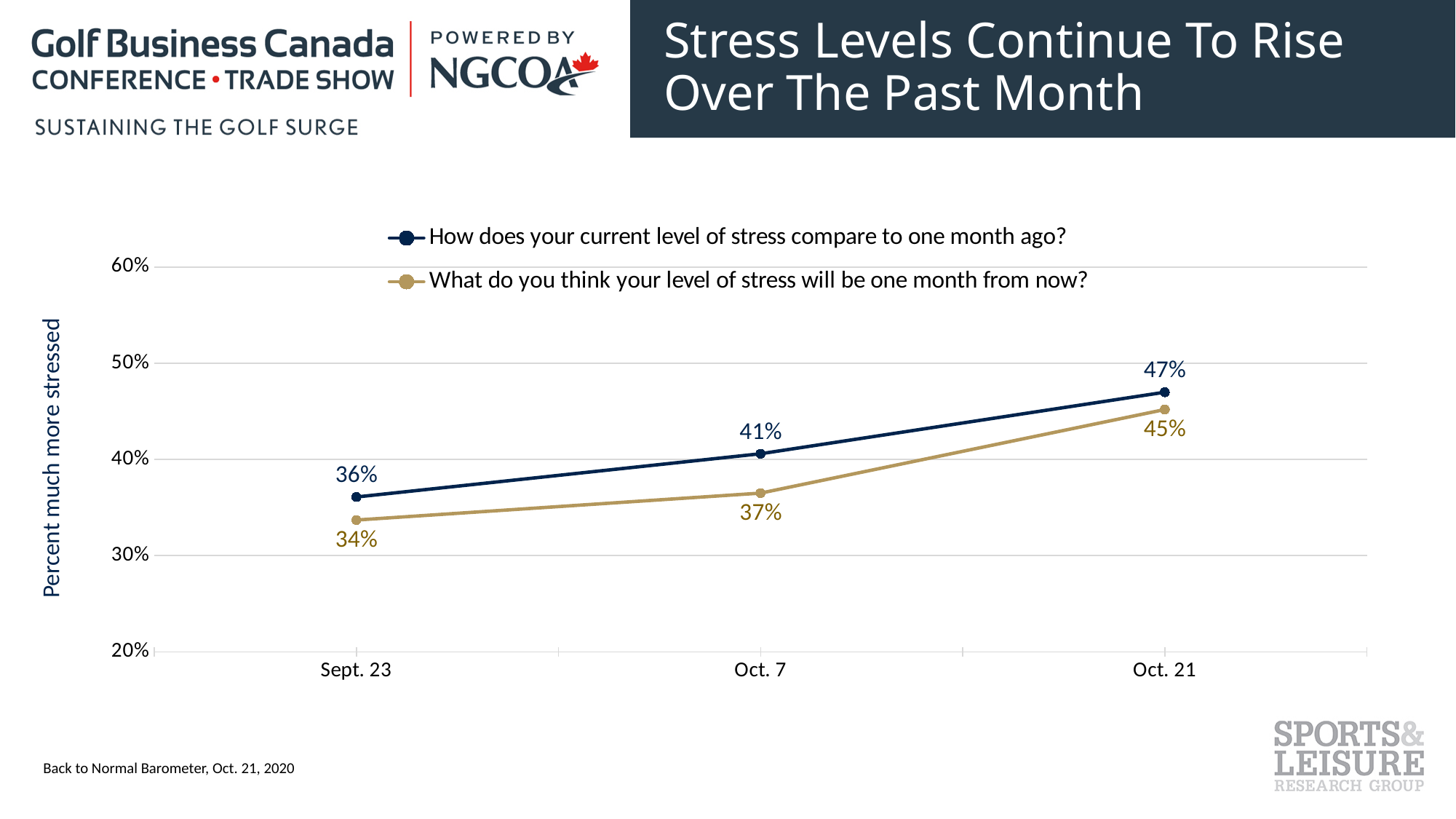
What is the value for 'How does your current level of stress compare to one month ago?' on Oct. 7? 41% How much did 'How does your current level of stress compare to one month ago?' increase from Sept. 23 to Oct. 21? 11% On which date is the 'How does your current level of stress compare to one month ago?' series lowest? Sept. 23 Do the values for 'What do you think your level of stress will be one month from now?' rise or fall from Sept. 23 to Oct. 21? Rise Which series has the higher value on Sept. 23? How does your current level of stress compare to one month ago? What kind of chart is shown on the slide? Line chart How many series does the legend list? 2 What is the value for 'How does your current level of stress compare to one month ago?' on Oct. 21? 47% On which date is the 'What do you think your level of stress will be one month from now?' series highest? Oct. 21 What is the value for 'What do you think your level of stress will be one month from now?' on Sept. 23? 34% How many dates are plotted on the x axis? 3 What is the difference between the two series on Oct. 7? 4%